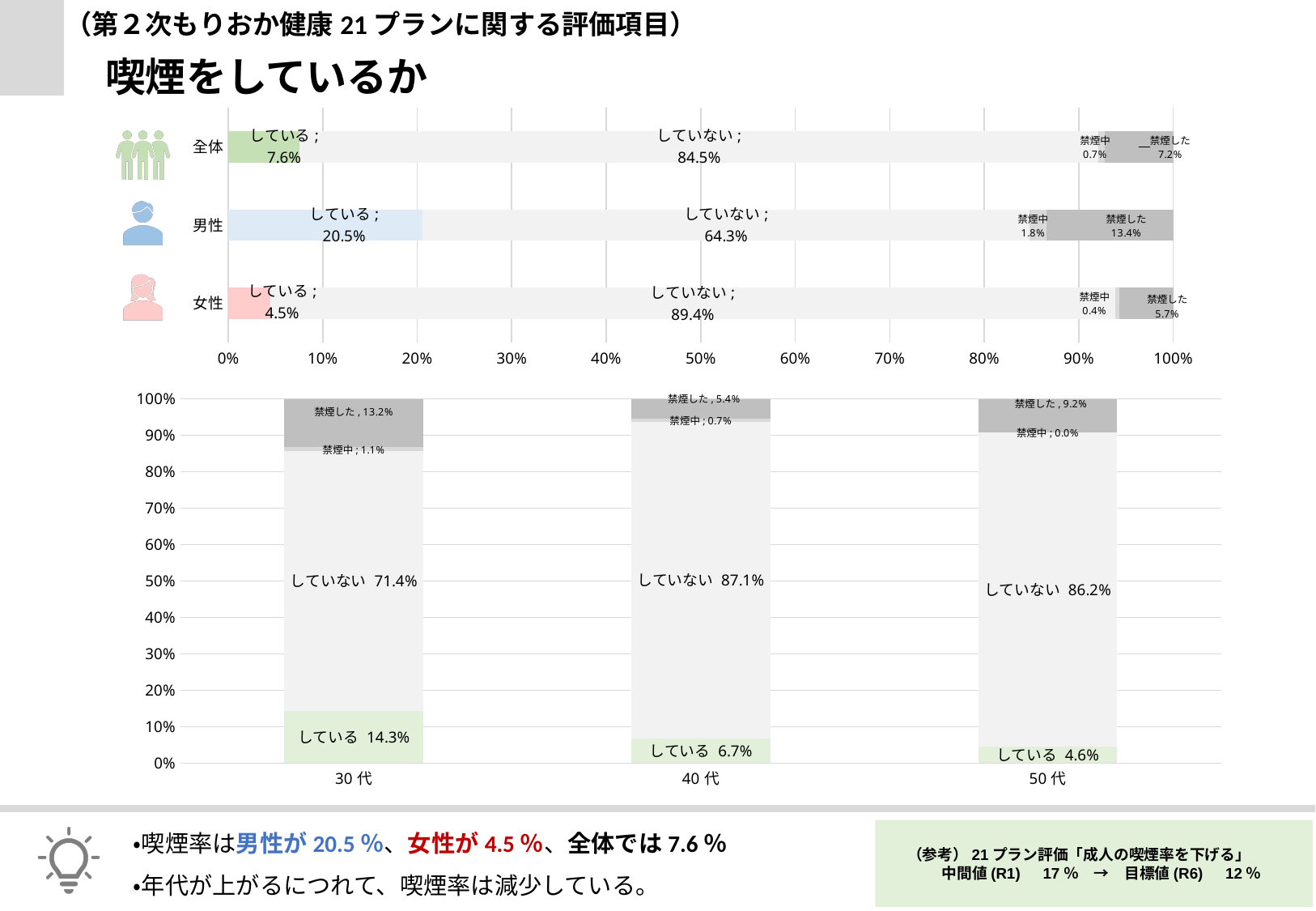
In the bottom chart (by age group), is the していない value larger for 40代 or 50代? 40代 In the top chart (horizontal bars), what is the difference between the している values for 男性 and 女性? 16.0% In the bottom chart (by age group), which age group has the lowest している value? 50代 What type of chart is the bottom chart (by age group)? Stacked bar chart In the top chart (horizontal bars), what is the value of していない for 女性? 89.4% In the bottom chart (by age group), what is the value of している for 30代? 14.3% In the top chart (horizontal bars), how many groups (bars) are shown? 3 In the bottom chart (by age group), how does the している value change from 30代 to 50代? It falls In the top chart (horizontal bars), what is the value of している for 男性? 20.5% In the top chart (horizontal bars), which group has the highest している value? 男性 In the bottom chart (by age group), what is the value of 禁煙した for 50代? 9.2% In the top chart (horizontal bars), what is the value of 禁煙した for 全体? 7.2%